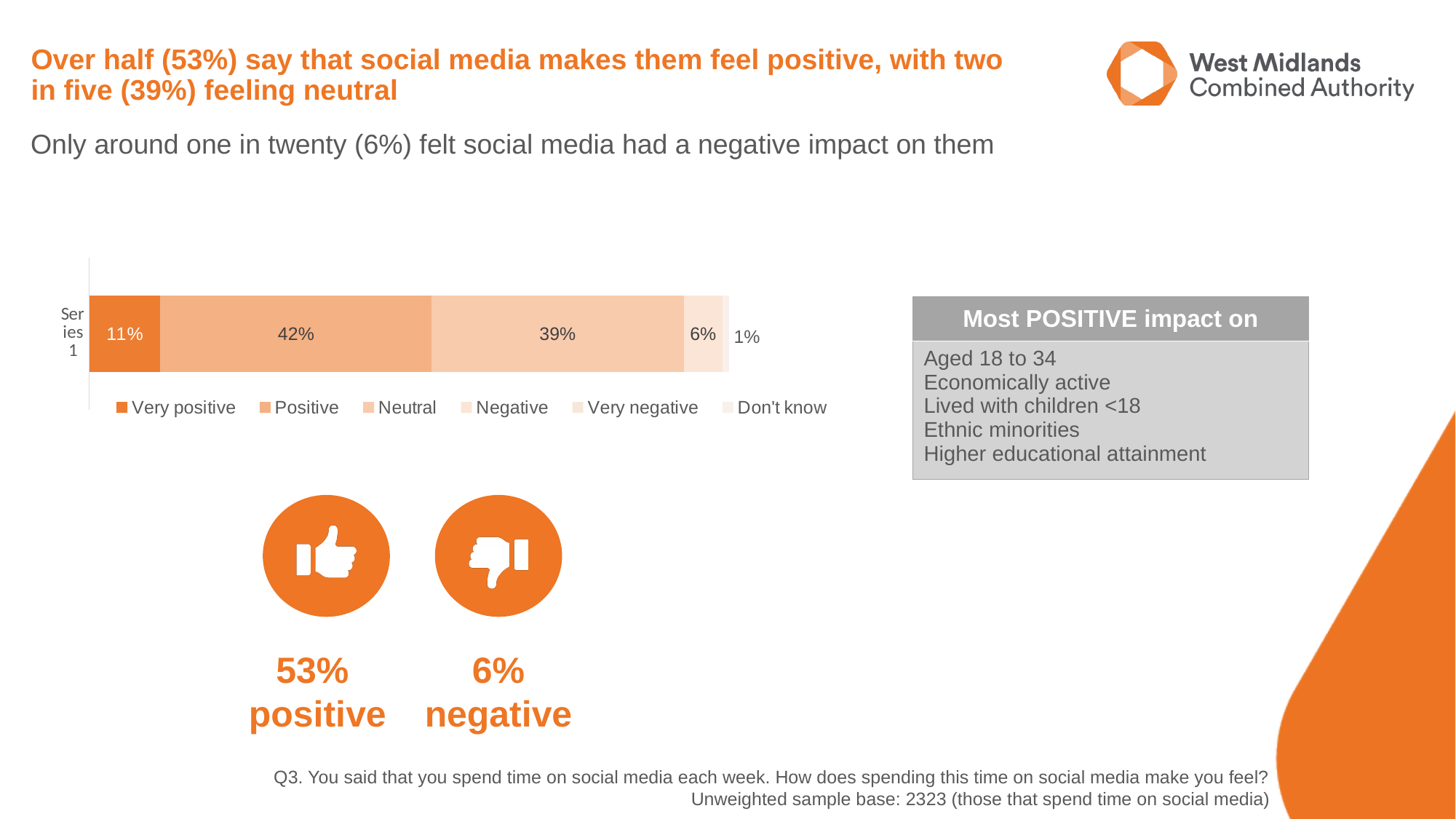
What type of chart is shown on the slide? Stacked bar chart What is the value shown for the Negative segment? 6% What is the first entry listed in the chart legend? Very positive Which response segment has the largest value in the stacked bar? Positive What is the difference between the Positive and Neutral segments? 3% What is the difference between the Very positive and Negative segments? 5% What percentage of respondents said social media makes them feel very positive? 11% Which is larger, the Very positive segment or the Negative segment? Very positive How many entries does the chart legend list? 6 What is the value of the Positive segment in the stacked bar? 42% What share of respondents felt neutral about social media's impact? 39% What is the combined value of the Very positive and Positive segments? 53%